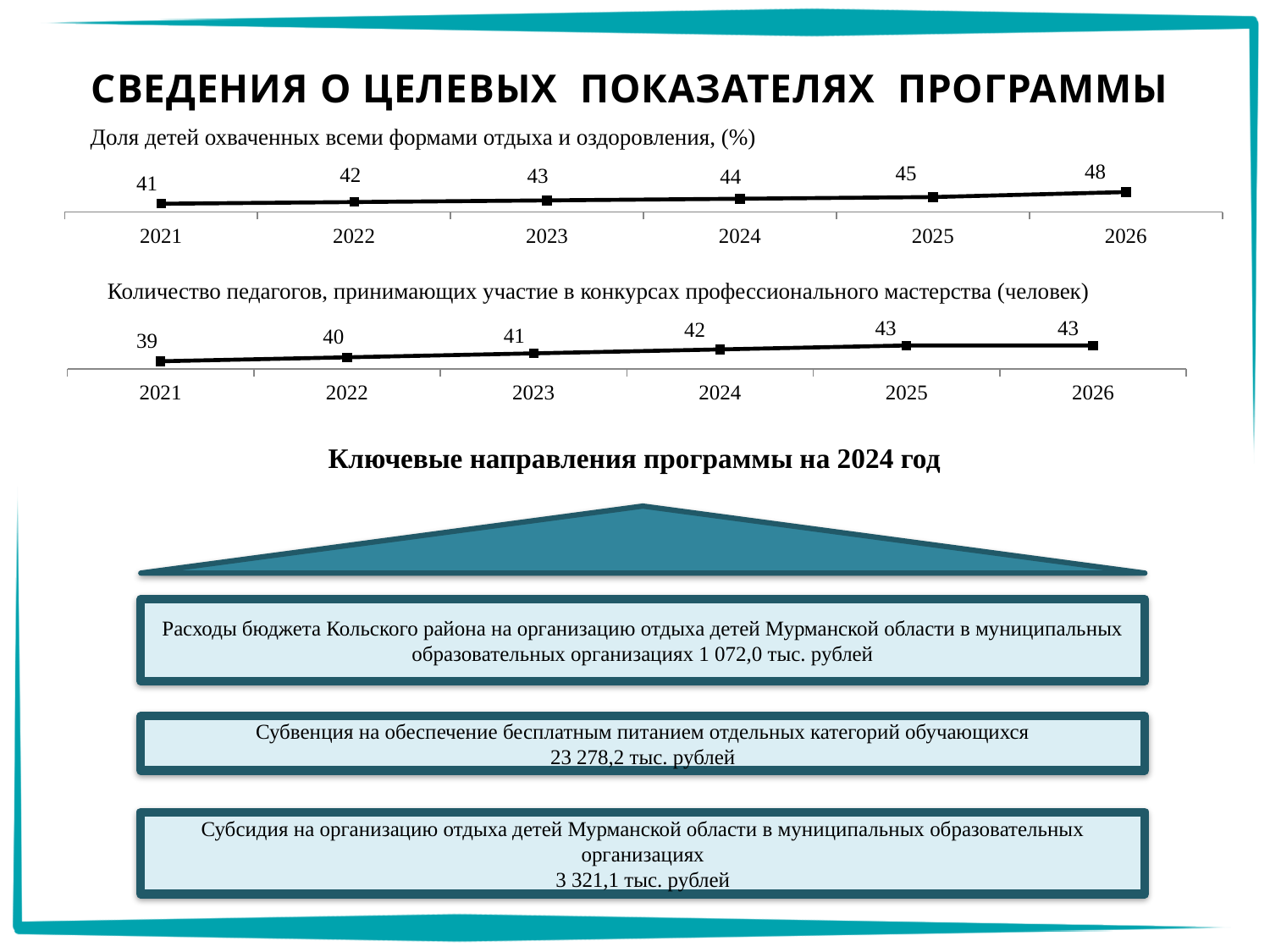
In the bottom chart, what is the difference between the values for 2024 and 2022? 2 In the top chart, is the value for 2025 larger or smaller than the value for 2023? larger What type of chart is the top chart? line chart In the top chart (share of children covered by all forms of rest and recreation), what is the value for 2024? 44 In the bottom chart (number of teachers participating in professional skill competitions), what is the value for 2021? 39 In the bottom chart, which year has the lowest value? 2021 In the top chart (share of children covered by all forms of rest and recreation), what is the value for 2026? 48 In the top chart, what is the difference between the values for 2026 and 2021? 7 In the bottom chart (number of teachers participating in professional skill competitions), what is the value for 2025? 43 How many data points are plotted in the bottom chart? 6 In the top chart, do the values rise or fall from 2021 to 2026? rise In the top chart, which year has the highest value? 2026